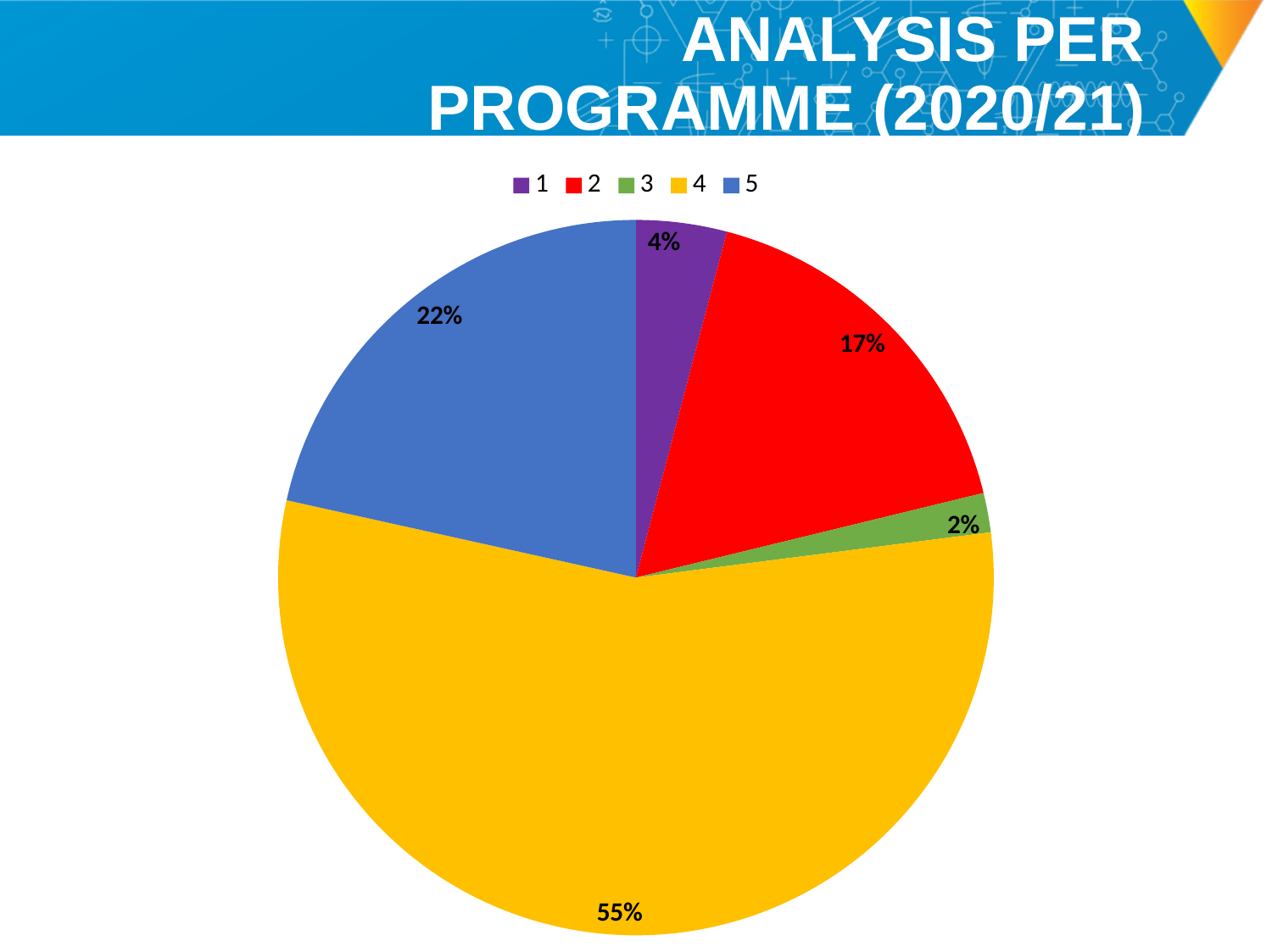
What is the value shown for programme 1? 4% What share of the pie does programme 4 have? 55% Which programme has the smallest slice of the pie? 3 Which programme has the largest slice of the pie? 4 What colour is the slice for programme 4? yellow What kind of chart is shown on the slide? pie chart How many slices does the pie chart have? 5 What is the value shown for programme 3? 2% Which is larger, the share for programme 2 or the share for programme 5? 5 What is the difference between the shares of programme 4 and programme 5? 33% What is the value shown for programme 2? 17% What share of the pie does programme 5 have? 22%